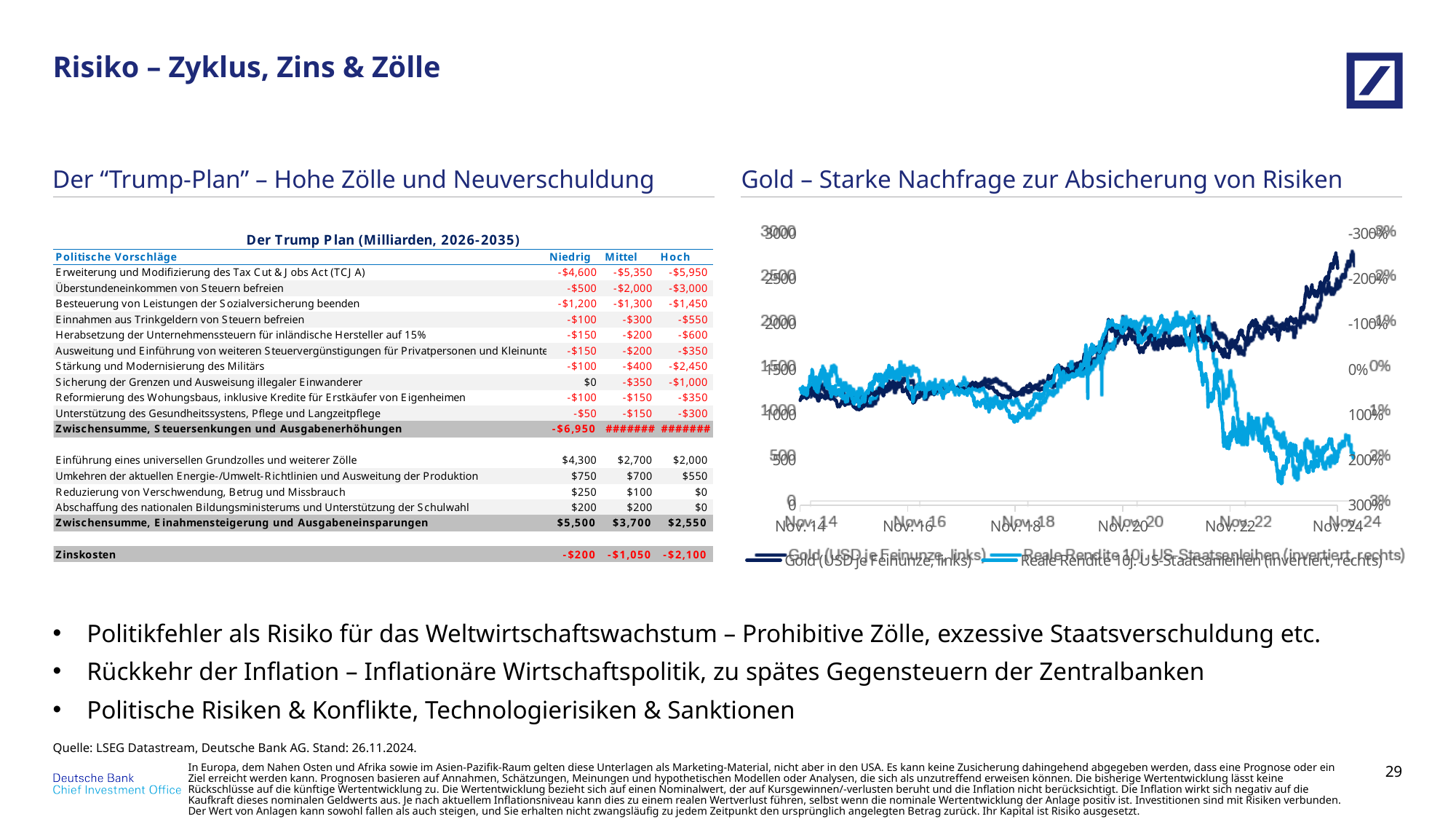
What kind of chart is shown under the heading "Gold – Starke Nachfrage zur Absicherung von Risiken"? Line chart In the gold chart, which series is plotted on the right-hand axis according to the legend? Reale Rendite 10j. US-Staatsanleihen (invertiert, rechts) In the gold chart, is the gold price at Nov. 20 greater or less than 1500? greater How many date labels are shown on the x axis of the gold chart? 6 How many series does the legend of the gold chart list? 2 In the gold chart, is the gold price at Nov. 14 greater or less than 1500? less In the gold chart, does the gold price rise or fall between Nov. 22 and Nov. 24? rise In the gold chart, is the gold price at Nov. 24 higher or lower than at Nov. 14? higher In the gold chart, is the gold price at Nov. 16 greater or less than 2000? less In the gold chart, does the gold price overall rise or fall from Nov. 14 to Nov. 24? rise In the gold chart, which series is plotted on the left-hand axis according to the legend? Gold (USD je Feinunze, links)